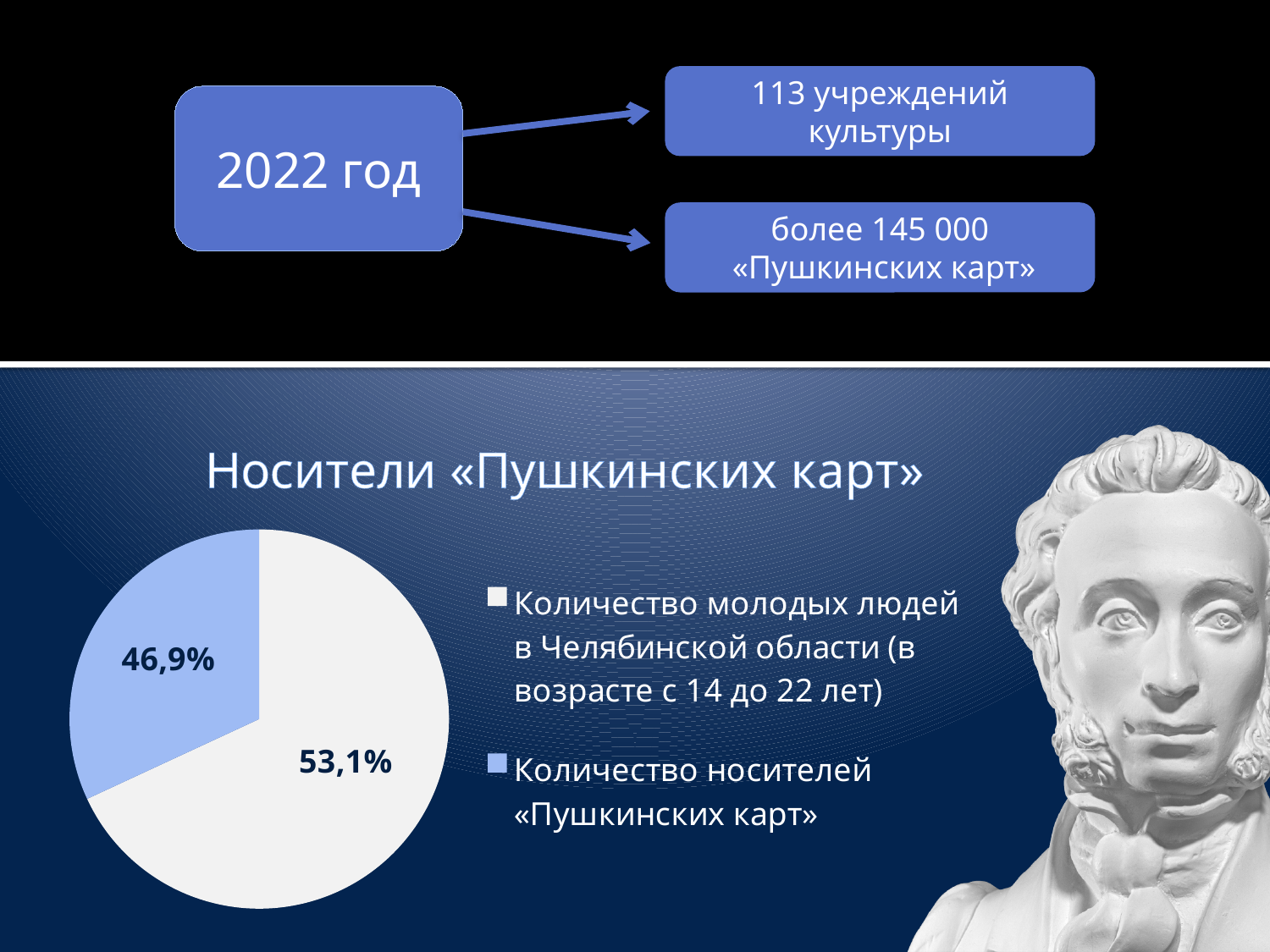
What kind of chart is shown on the slide? pie chart Which slice of the pie chart is the smallest? Количество носителей «Пушкинских карт» What share of the pie is labelled "Количество молодых людей в Челябинской области (в возрасте с 14 до 22 лет)"? 53,1% What share of the pie is labelled "Количество носителей «Пушкинских карт»"? 46,9% What is the title of the pie chart? Носители «Пушкинских карт» What colour is the slice for "Количество носителей «Пушкинских карт»" in the pie chart? light blue What is the difference in percentage points between the two slices of the pie chart? 6,2 How many entries does the legend of the pie chart list? 2 Which is larger: the share for "Количество носителей «Пушкинских карт»" or the share for "Количество молодых людей в Челябинской области"? Количество молодых людей в Челябинской области Is the share for "Количество носителей «Пушкинских карт»" greater or less than 50%? less How many slices does the pie chart have? 2 Which slice of the pie chart is the largest? Количество молодых людей в Челябинской области (в возрасте с 14 до 22 лет)